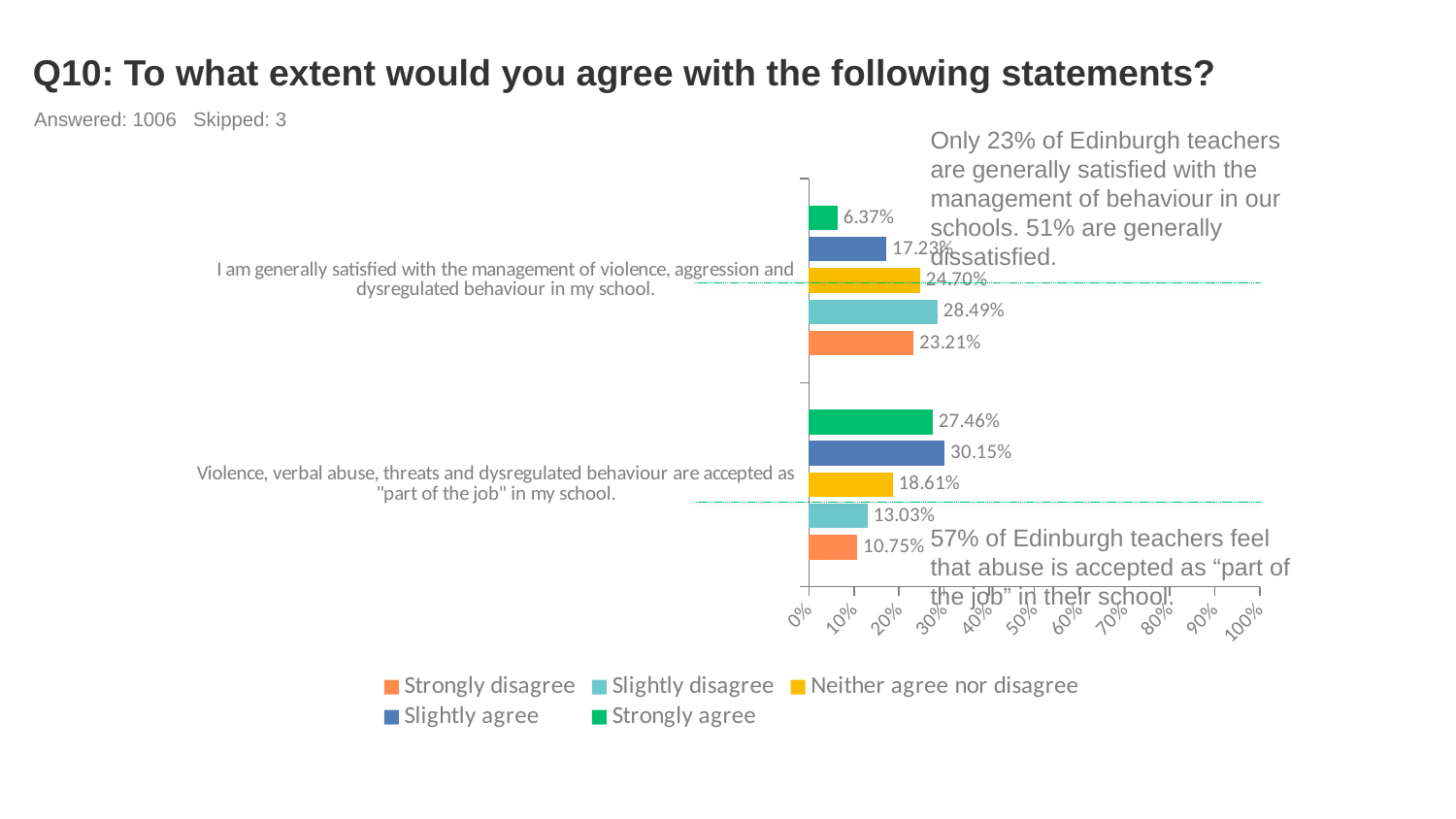
For the 'part of the job' statement, which response option has the highest percentage? Slightly agree What is the Strongly disagree value for the 'part of the job' statement? 10.75% How many statements (categories) are plotted on the chart? 2 What colour represents Strongly agree in the legend? Green What is the Slightly agree value for the statement that violence, verbal abuse, threats and dysregulated behaviour are accepted as 'part of the job'? 30.15% Which statement has the larger Neither agree nor disagree value: the 'generally satisfied' statement or the 'part of the job' statement? The 'generally satisfied' statement What percentage of respondents strongly agree that they are generally satisfied with the management of violence, aggression and dysregulated behaviour in their school? 6.37% What is the Slightly disagree value for the statement 'I am generally satisfied with the management of violence, aggression and dysregulated behaviour in my school'? 28.49% How many series does the legend list? 5 For the statement about being generally satisfied with the management of behaviour, which response option has the lowest percentage? Strongly agree What is the difference between the Strongly agree values for the 'part of the job' statement (27.46%) and the 'generally satisfied' statement (6.37%)? 21.09 percentage points What kind of chart is shown on the slide? bar chart